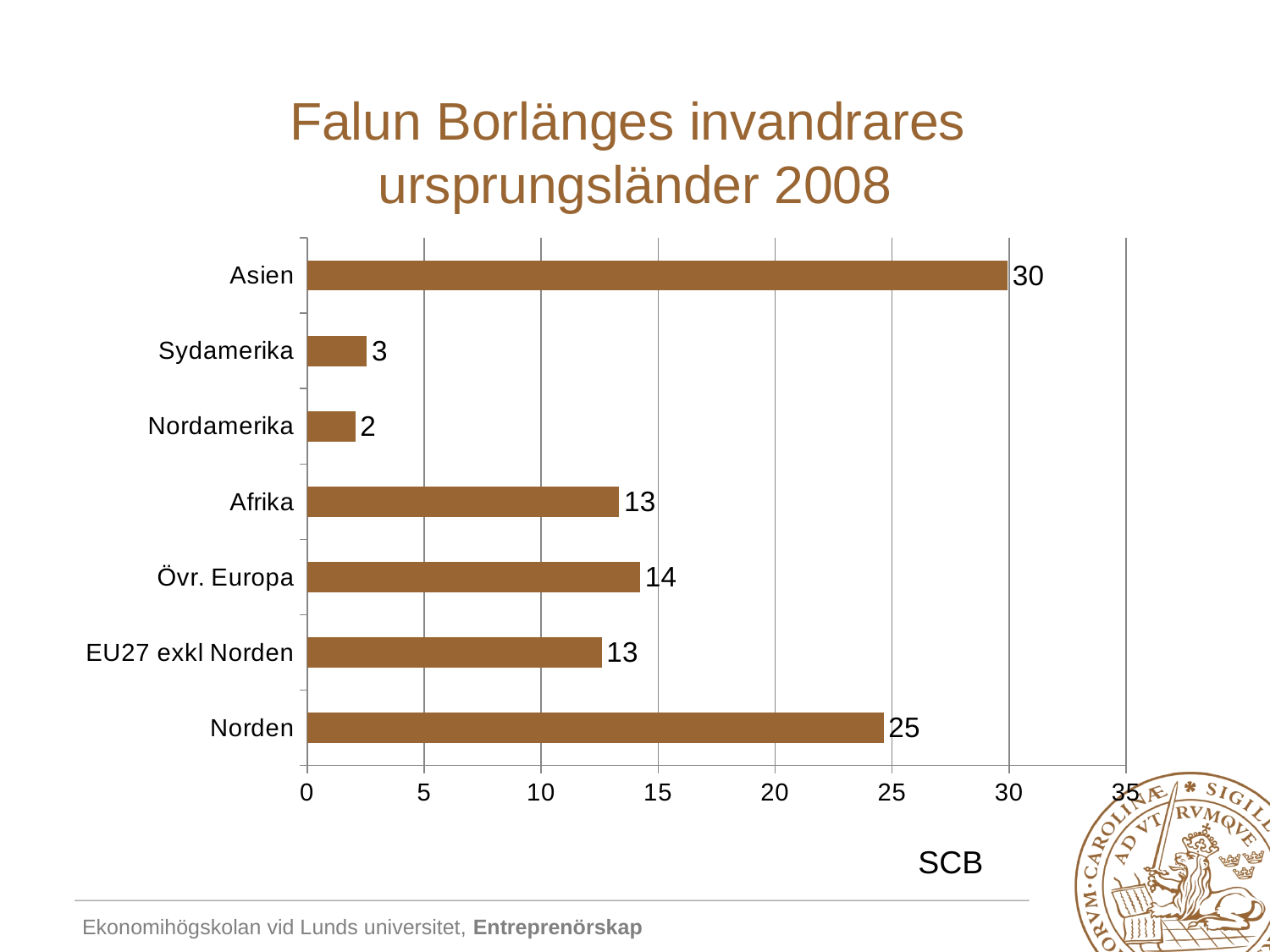
How many categories are shown in the chart? 7 What is the difference between the values for Asien and Norden? 5 What kind of chart is shown on the slide? bar chart What is the value for Norden? 25 What is the value for Asien? 30 What is the value for Övr. Europa? 14 What is the title of the chart? Falun Borlänges invandrares ursprungsländer 2008 Which category has the lowest value? Nordamerika Which is larger, the value for Afrika or the value for Övr. Europa? Övr. Europa Which category has the highest value? Asien What is the value for Nordamerika? 2 Is the value for Norden greater or less than 20? greater